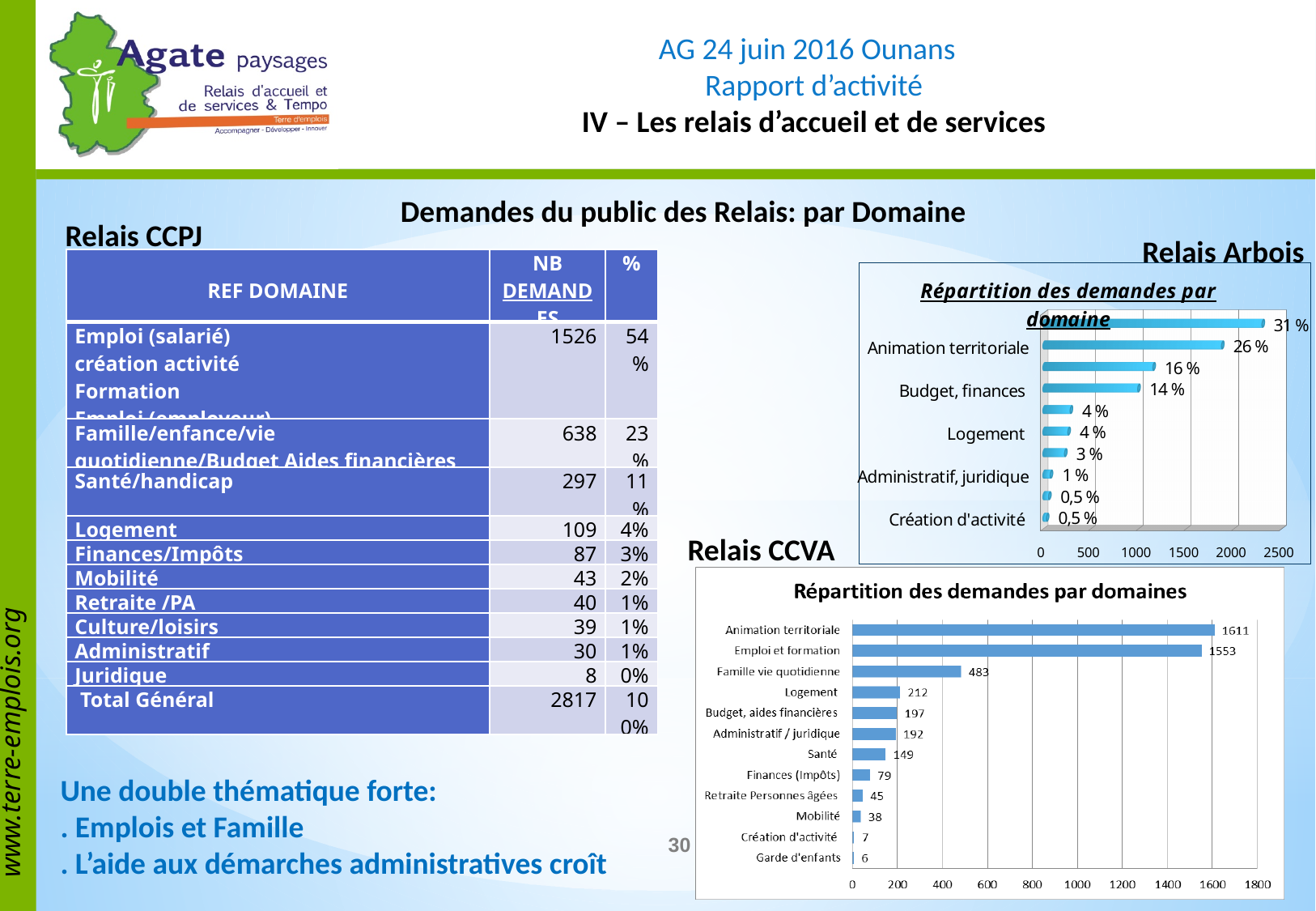
In the Relais Arbois chart, what is the highest percentage shown? 31 % In the Relais Arbois chart, what is the value for Création d'activité? 0,5 % In the Relais CCVA chart, which category has the highest value? Animation territoriale How many categories are shown in the Relais CCVA chart? 12 What kind of chart is the Relais CCVA chart? Bar chart In the Relais CCVA chart, what is the difference between Animation territoriale and Emploi et formation? 58 In the Relais CCVA chart, which is larger: Logement or Santé? Logement In the Relais Arbois chart, what is the value for Animation territoriale? 26 % What is the title of the Relais CCVA chart? Répartition des demandes par domaines In the Relais CCVA chart, which category has the lowest value? Garde d'enfants In the Relais CCVA chart, what is the value for Animation territoriale? 1611 In the Relais CCVA chart, what is the value for Famille vie quotidienne? 483